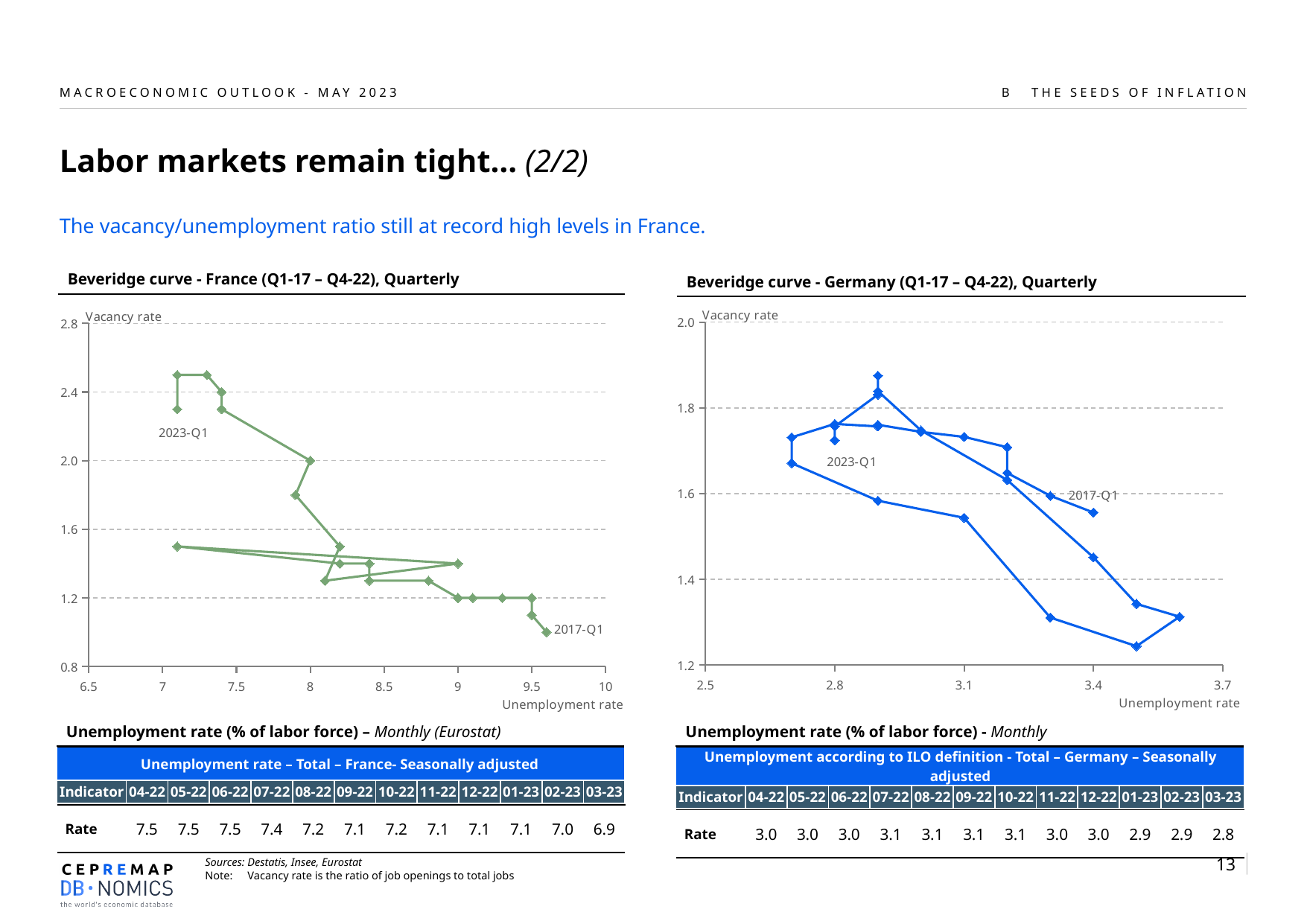
On the Beveridge curve - Germany chart, which point has the higher unemployment rate, 2017-Q1 or 2023-Q1? 2017-Q1 On the Beveridge curve - France chart, is the unemployment rate for 2017-Q1 greater or less than 9? greater On the Beveridge curve - France chart, is the unemployment rate for 2023-Q1 greater or less than 7.5? less On the Beveridge curve - France chart, is the vacancy rate for 2023-Q1 greater or less than 2.0? greater On the Beveridge curve - France chart, which point has the higher vacancy rate, 2017-Q1 or 2023-Q1? 2023-Q1 What kind of chart is the Beveridge curve - France chart? line chart What is the label of the vertical axis on the Beveridge curve - France chart? Vacancy rate What is the label of the horizontal axis on the Beveridge curve - Germany chart? Unemployment rate